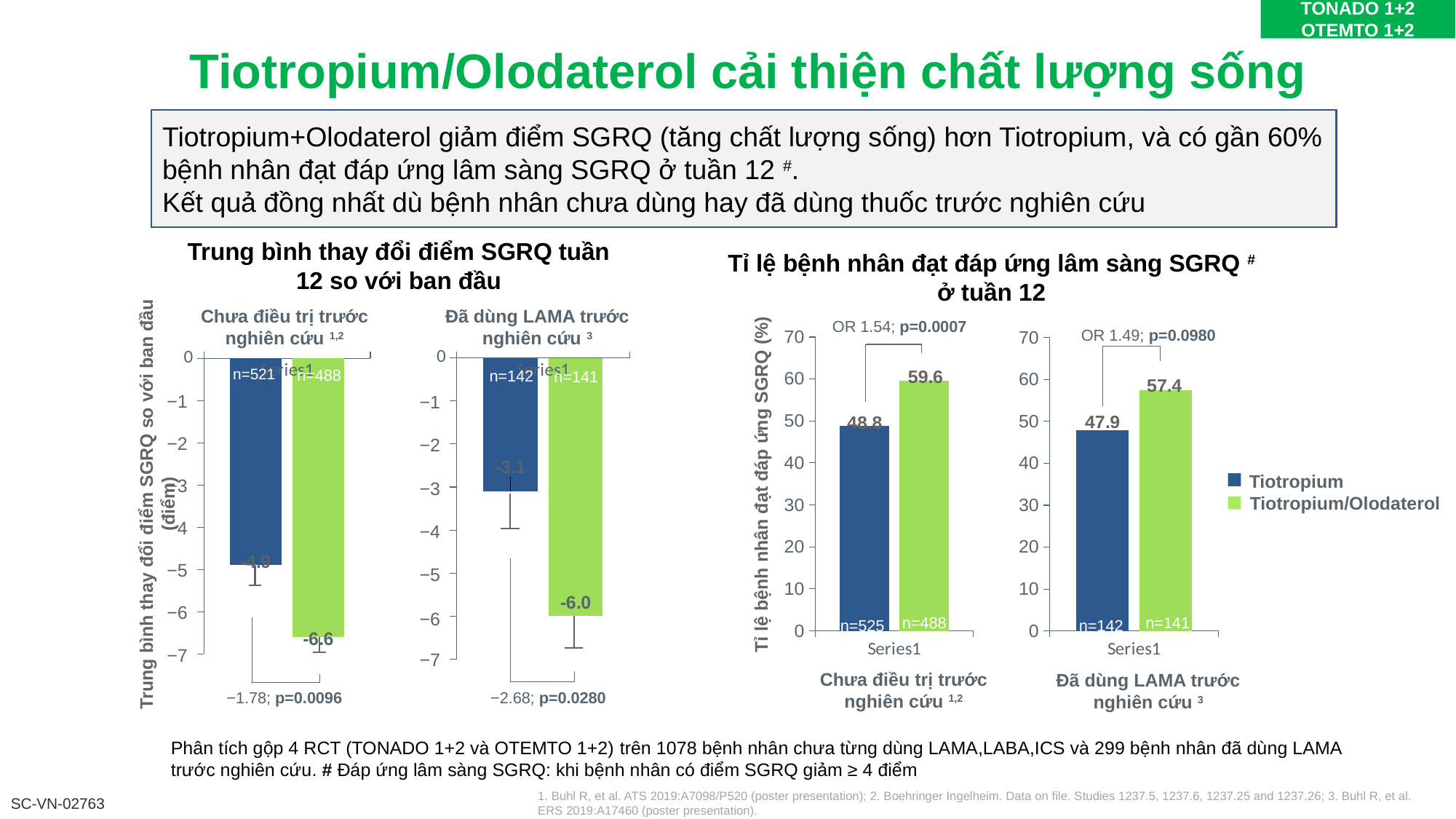
In the chart 'Tỉ lệ bệnh nhân đạt đáp ứng lâm sàng SGRQ ở tuần 12', what is the value for Tiotropium/Olodaterol in the 'Chưa điều trị trước nghiên cứu' group? 59.6 In the chart 'Trung bình thay đổi điểm SGRQ tuần 12 so với ban đầu', what is the value for Tiotropium/Olodaterol in the 'Chưa điều trị trước nghiên cứu' group? -6.6 In the chart 'Tỉ lệ bệnh nhân đạt đáp ứng lâm sàng SGRQ ở tuần 12', what odds ratio and p-value are shown for the 'Chưa điều trị trước nghiên cứu' group? OR 1.54; p=0.0007 In the chart 'Tỉ lệ bệnh nhân đạt đáp ứng lâm sàng SGRQ ở tuần 12', what is the difference between Tiotropium/Olodaterol and Tiotropium in the 'Chưa điều trị trước nghiên cứu' group? 10.8 How many series does the legend on the right side of the slide list? 2 In the chart 'Tỉ lệ bệnh nhân đạt đáp ứng lâm sàng SGRQ ở tuần 12', what is the difference between Tiotropium/Olodaterol and Tiotropium in the 'Đã dùng LAMA trước nghiên cứu' group? 9.5 In the chart 'Trung bình thay đổi điểm SGRQ tuần 12 so với ban đầu', which treatment shows the larger decrease in the 'Đã dùng LAMA trước nghiên cứu' group, Tiotropium or Tiotropium/Olodaterol? Tiotropium/Olodaterol In the chart 'Trung bình thay đổi điểm SGRQ tuần 12 so với ban đầu', what is the value for Tiotropium in the 'Đã dùng LAMA trước nghiên cứu' group? -3.1 In the chart 'Trung bình thay đổi điểm SGRQ tuần 12 so với ban đầu', is the value for Tiotropium in the 'Chưa điều trị trước nghiên cứu' group greater or less than -4? less What kind of chart is 'Tỉ lệ bệnh nhân đạt đáp ứng lâm sàng SGRQ ở tuần 12'? Bar chart In the chart 'Tỉ lệ bệnh nhân đạt đáp ứng lâm sàng SGRQ ở tuần 12', what is the value for Tiotropium in the 'Đã dùng LAMA trước nghiên cứu' group? 47.9 In the chart 'Tỉ lệ bệnh nhân đạt đáp ứng lâm sàng SGRQ ở tuần 12', which bar is the highest across both groups? Tiotropium/Olodaterol, Chưa điều trị trước nghiên cứu (59.6)